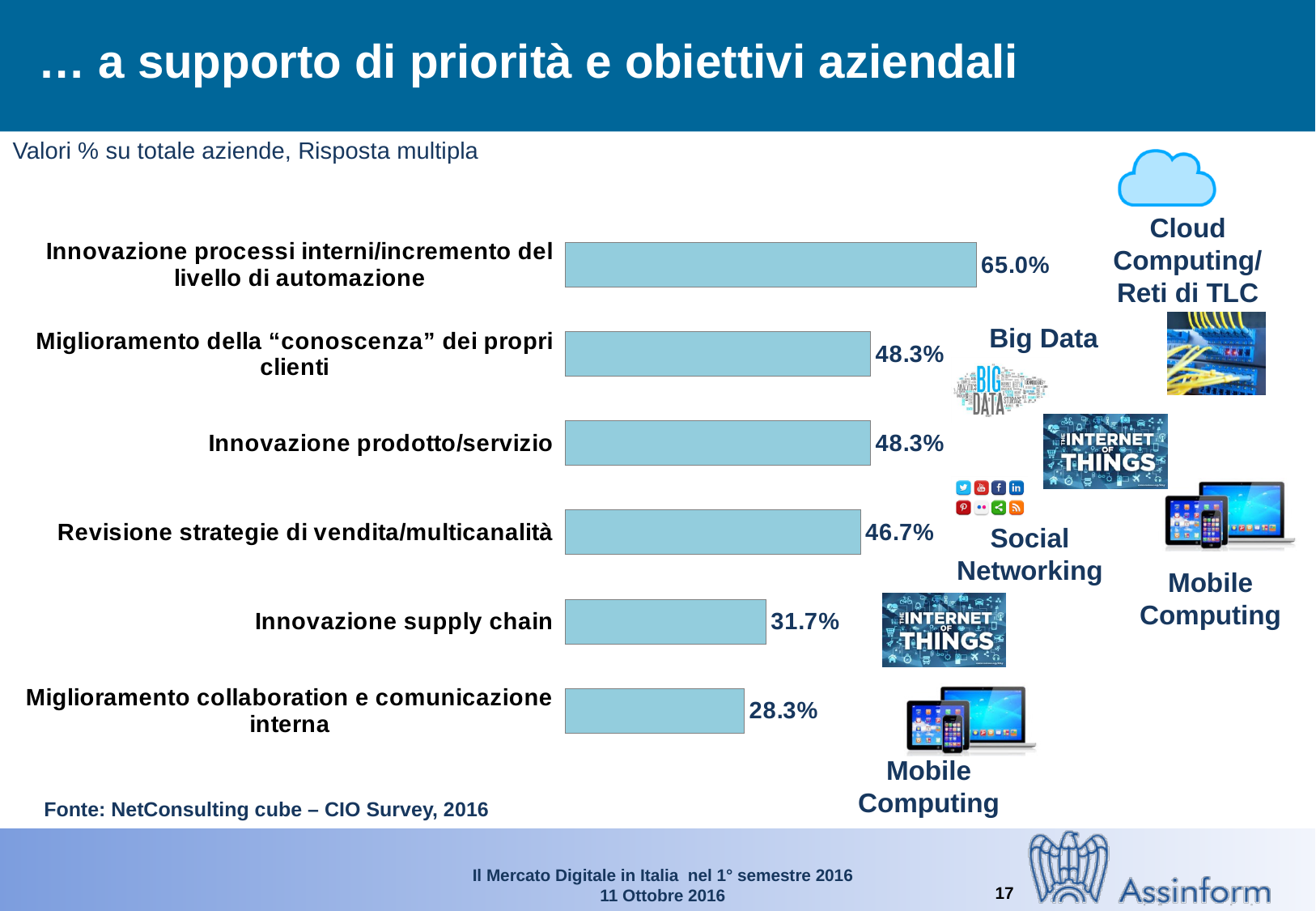
What is the value for "Revisione strategie di vendita/multicanalità"? 46.7% What is the value for "Innovazione processi interni/incremento del livello di automazione"? 65.0% What source is cited for the chart data? NetConsulting cube – CIO Survey, 2016 How many categories are shown in the chart? 6 What is the value for "Miglioramento collaboration e comunicazione interna"? 28.3% What kind of chart is shown on the slide? Bar chart Which category has the lowest value? Miglioramento collaboration e comunicazione interna Which category has the highest value? Innovazione processi interni/incremento del livello di automazione Which is larger: the value for "Innovazione supply chain" or for "Miglioramento collaboration e comunicazione interna"? Innovazione supply chain What is the value for "Innovazione supply chain"? 31.7% Which two categories share the same value of 48.3%? Miglioramento della "conoscenza" dei propri clienti and Innovazione prodotto/servizio What is the difference between the values for "Innovazione processi interni/incremento del livello di automazione" and "Innovazione supply chain"? 33.3%